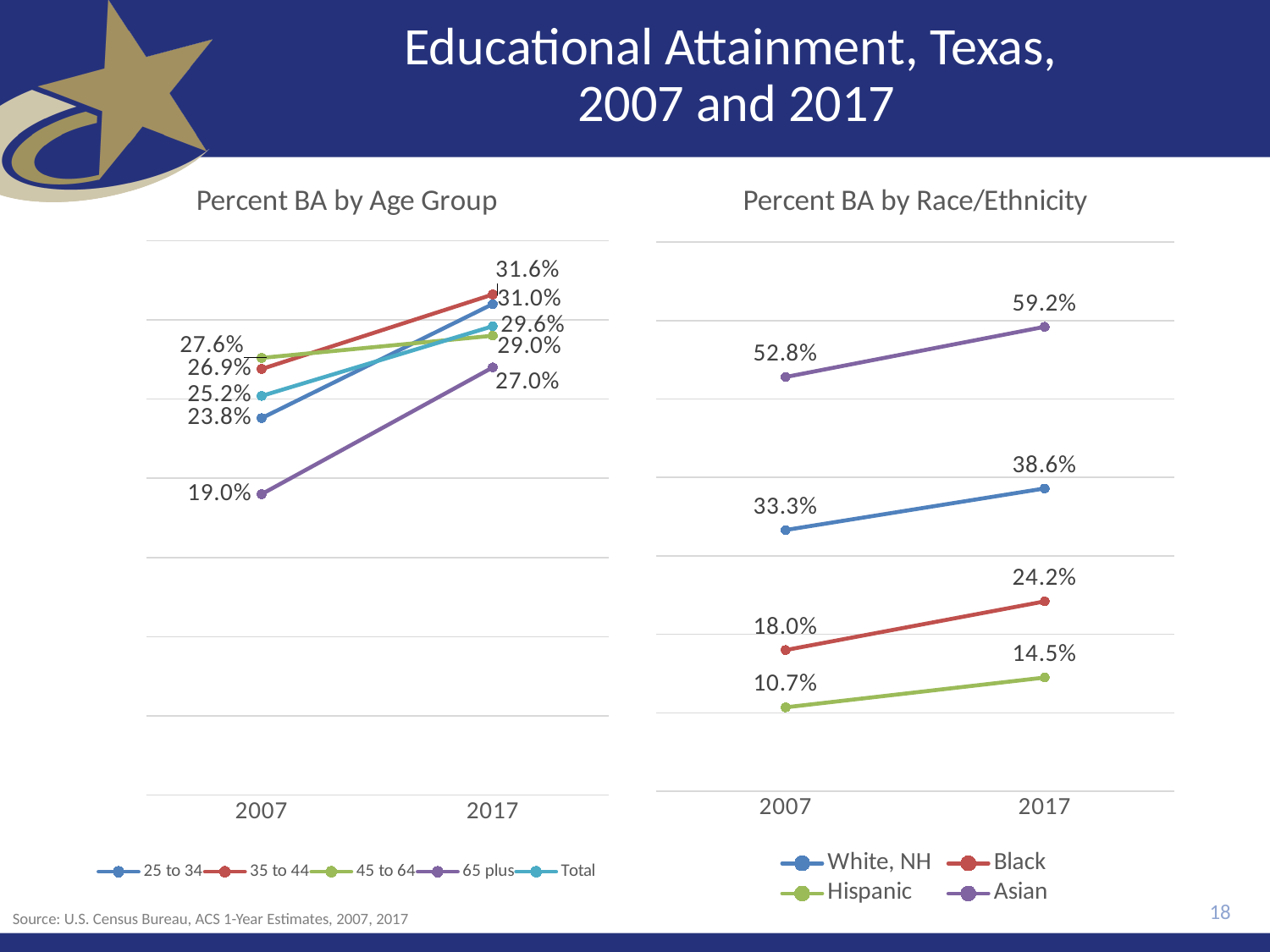
In the Percent BA by Race/Ethnicity chart, which group has the highest value in 2017? Asian In the Percent BA by Race/Ethnicity chart, what is the value for Asian in 2017? 59.2% In the Percent BA by Race/Ethnicity chart, how many series does the legend list? 4 In the Percent BA by Age Group chart, how many series does the legend list? 5 In the Percent BA by Race/Ethnicity chart, what is the value for Hispanic in 2007? 10.7% In the Percent BA by Age Group chart, which age group has the lowest value in 2007? 65 plus In the Percent BA by Age Group chart, what is the value for 65 plus in 2017? 27.0% In the Percent BA by Age Group chart, what is the value for 65 plus in 2007? 19.0% What kind of chart is the Percent BA by Age Group chart? Line chart In the Percent BA by Race/Ethnicity chart, which group has the lowest value in 2007? Hispanic In the Percent BA by Race/Ethnicity chart, what is the value for Black in 2017? 24.2% In the Percent BA by Race/Ethnicity chart, by how much did the value for White, NH change from 2007 to 2017? 5.3%